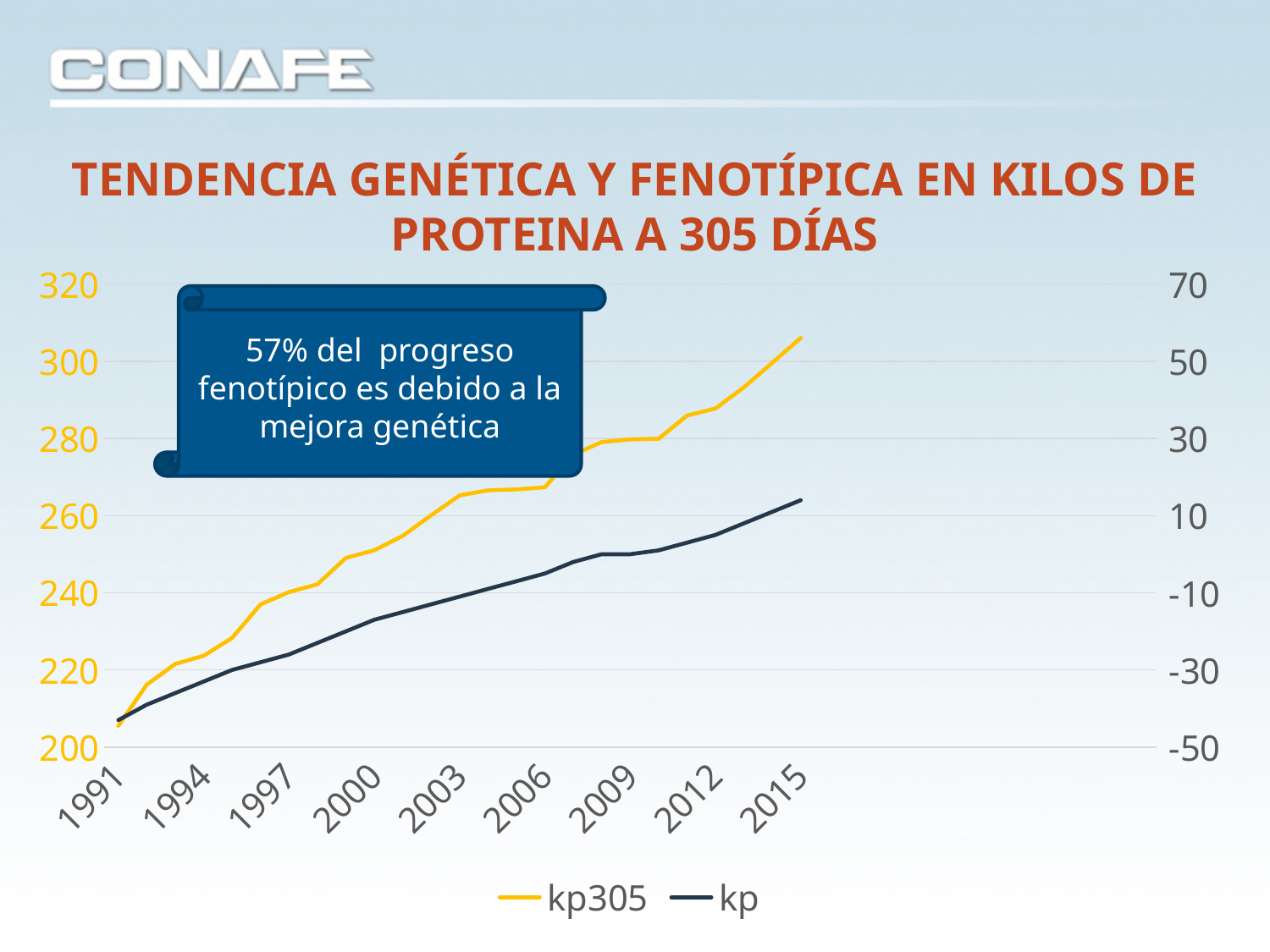
Is the value for kp305 in 2015 greater or less than 300? greater What kind of chart is shown on the slide? line chart Is the value for kp in 1991 greater or less than -30 on the right axis? less Is the value for kp305 in 1991 greater or less than 220? less How many series does the legend list? 2 What are the names of the two series in the legend? kp305 and kp Does the kp305 line rise or fall from 1991 to 2015? rise Does the kp line rise or fall from 1991 to 2015? rise How many year labels are shown on the x axis? 9 What is the first year shown on the x axis? 1991 Which series is drawn in yellow? kp305